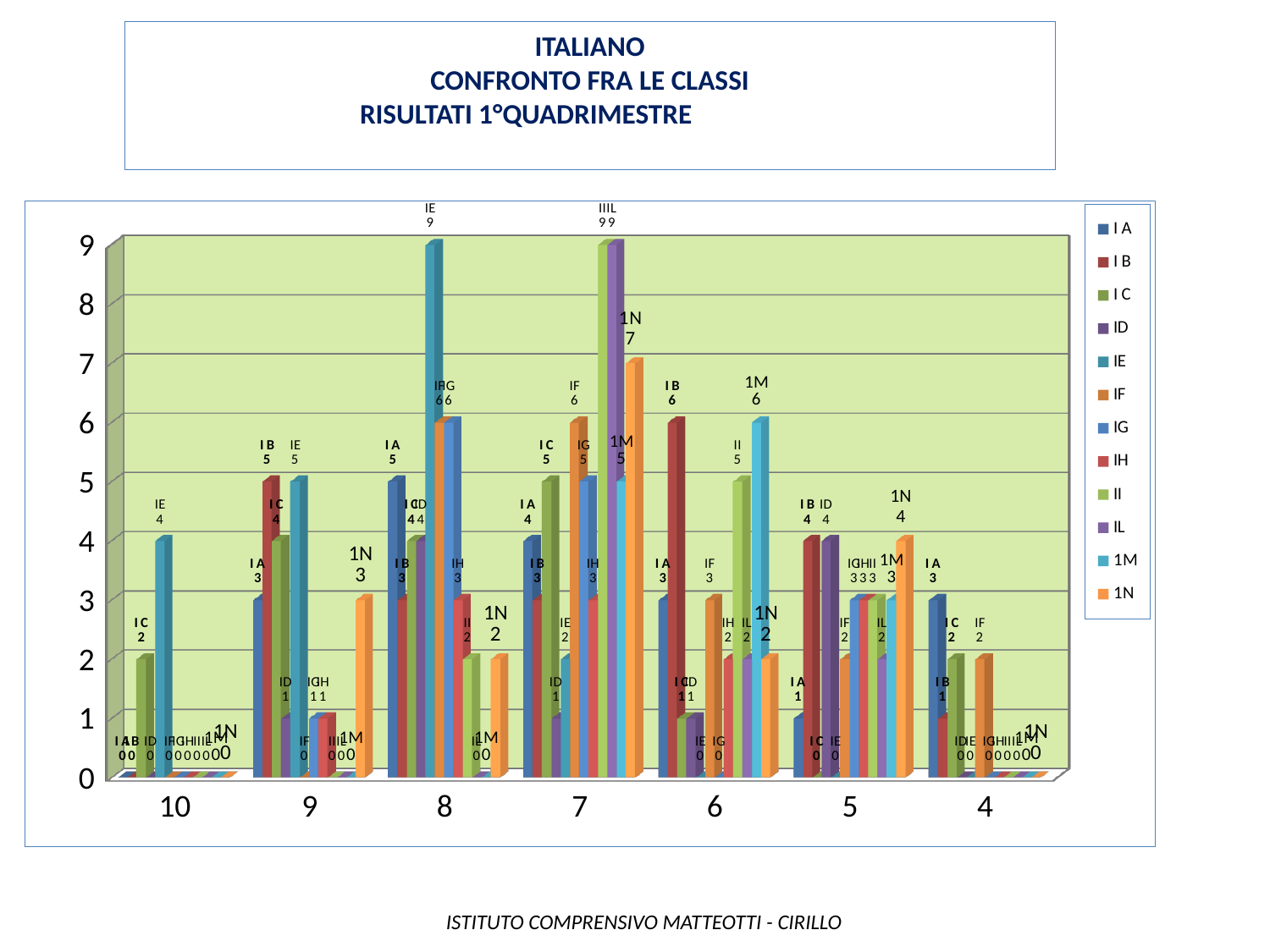
What is the value for series IE at category 8? 9 What is the value for series I B at category 6? 6 Which series has the highest value at category 6? I B and 1M What is the value for series I C at category 10? 2 What is the value for series 1N at category 7? 7 How many categories are shown on the x axis? 7 Which is larger at category 9: the value for I B or the value for I A? I B How many series does the legend list? 12 At which category does series 1N reach its highest value? 7 What is the difference between the value for IE at category 8 and the value for IE at category 10? 5 What kind of chart is shown on the slide? bar chart What is the first line of the chart title? ITALIANO